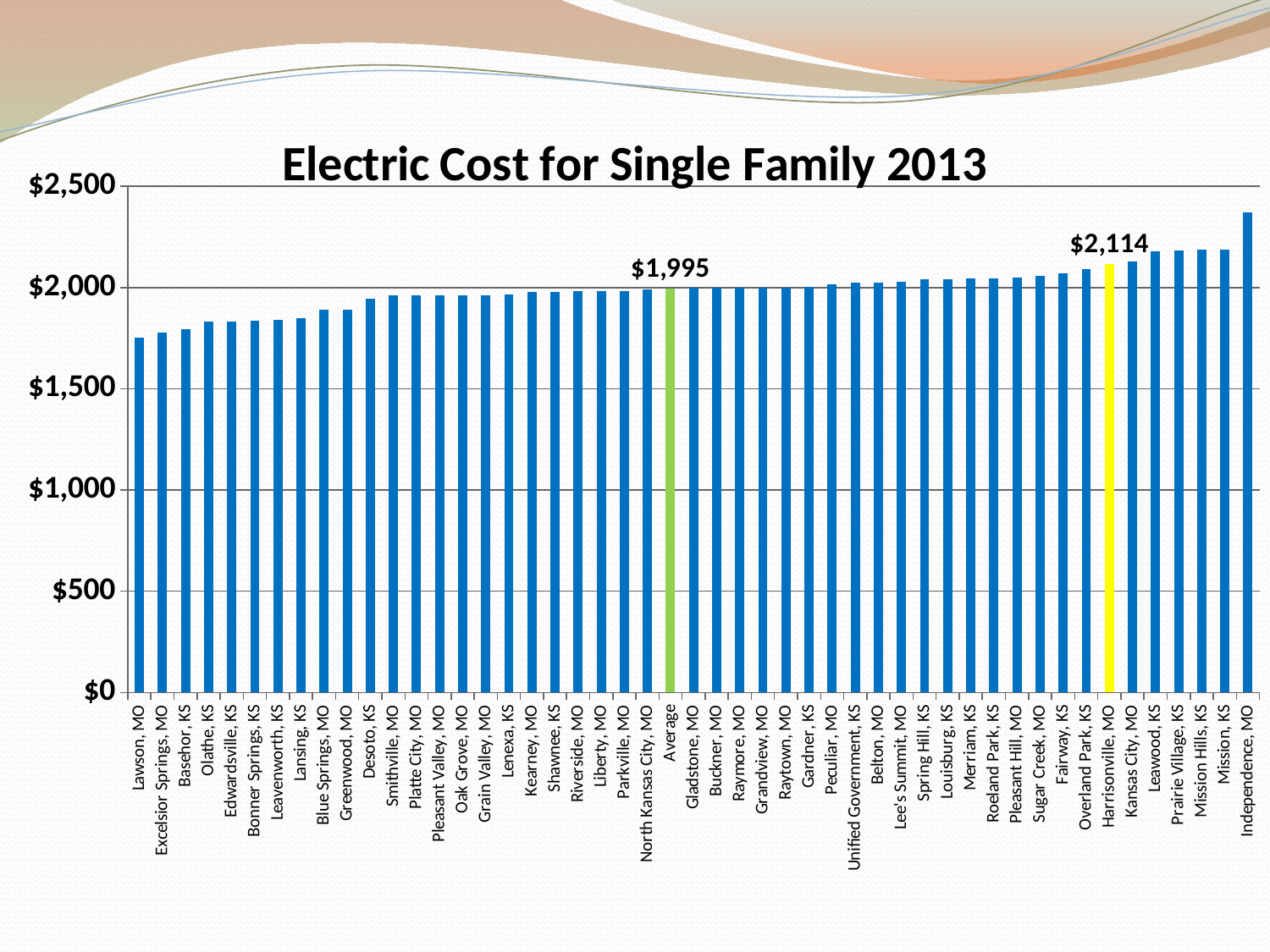
Is the value for Lawson, MO greater or less than $2,000? less Do the values generally rise or fall from left to right along the x axis? rise Which is larger, the value for Harrisonville, MO or the Average? Harrisonville, MO Which category has the lowest electric cost? Lawson, MO What is the value shown for Average? $1,995 Is the value for Mission Hills, KS greater or less than $2,000? greater What colour is the bar for Harrisonville, MO? Yellow Which category has the highest electric cost? Independence, MO What is the difference between the value for Harrisonville, MO and the Average? $119 What is the title of the chart? Electric Cost for Single Family 2013 What type of chart is shown on the slide? Bar chart What is the value shown for Harrisonville, MO? $2,114